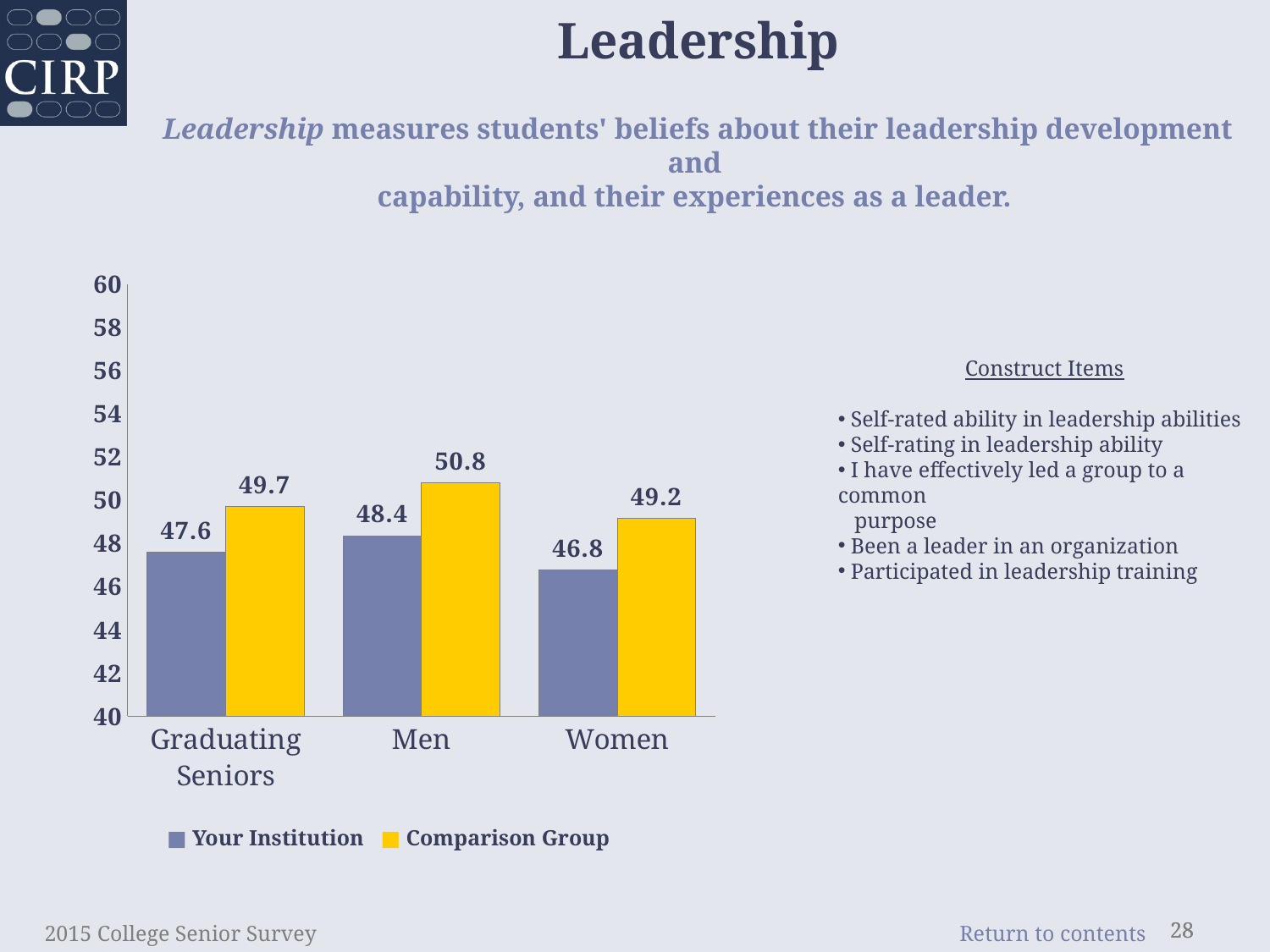
Which category has the highest Comparison Group value? Men For Men, which is larger: Your Institution or Comparison Group? Comparison Group Which category has the lowest Your Institution value? Women What is the Your Institution value for Graduating Seniors? 47.6 How many categories are shown on the x axis? 3 What is the Your Institution value for Women? 46.8 How many series does the legend list? 2 What is the difference between the Comparison Group and Your Institution values for Women? 2.4 What kind of chart is shown on the slide? bar chart What is the Comparison Group value for Graduating Seniors? 49.7 What is the Comparison Group value for Men? 50.8 Is the Your Institution value for Men greater or less than 50? less